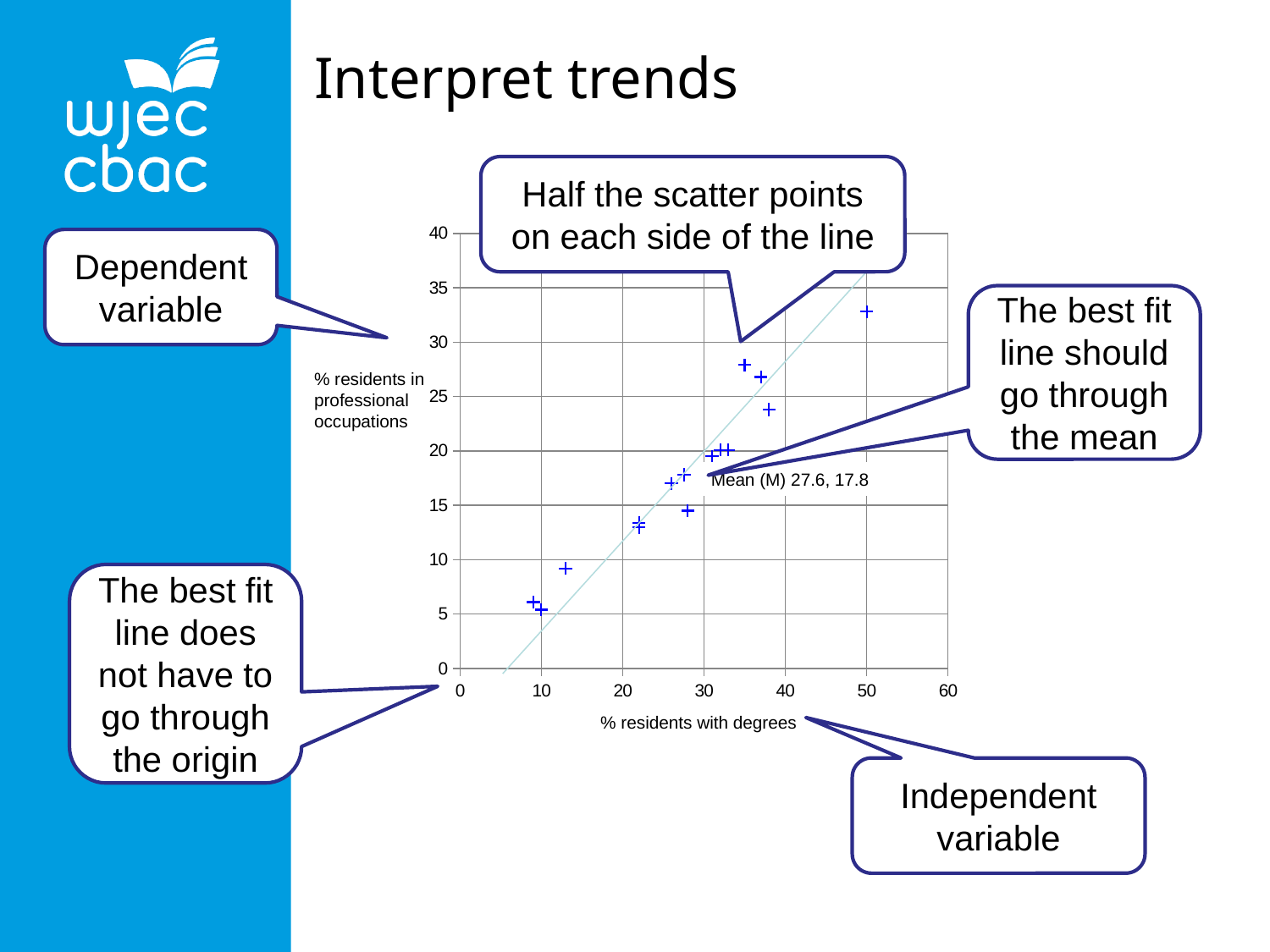
What mean value is printed on the chart? 27.6, 17.8 What is the highest value shown on the x axis of the chart? 60 Is the % residents in professional occupations for the lowest scatter point greater or less than 10? less What is the label of the y axis of the chart? % residents in professional occupations What is the mean % residents with degrees shown on the chart? 27.6 Is the % residents with degrees for the rightmost scatter point greater or less than 40? greater Is the % residents in professional occupations for the point with the highest % residents with degrees greater or less than 30? greater What kind of chart is shown on the slide? Scatter chart What is the label of the x axis of the chart? % residents with degrees What is the highest value shown on the y axis of the chart? 40 Do the scatter points rise or fall as % residents with degrees increases? Rise What is the mean % residents in professional occupations shown on the chart? 17.8